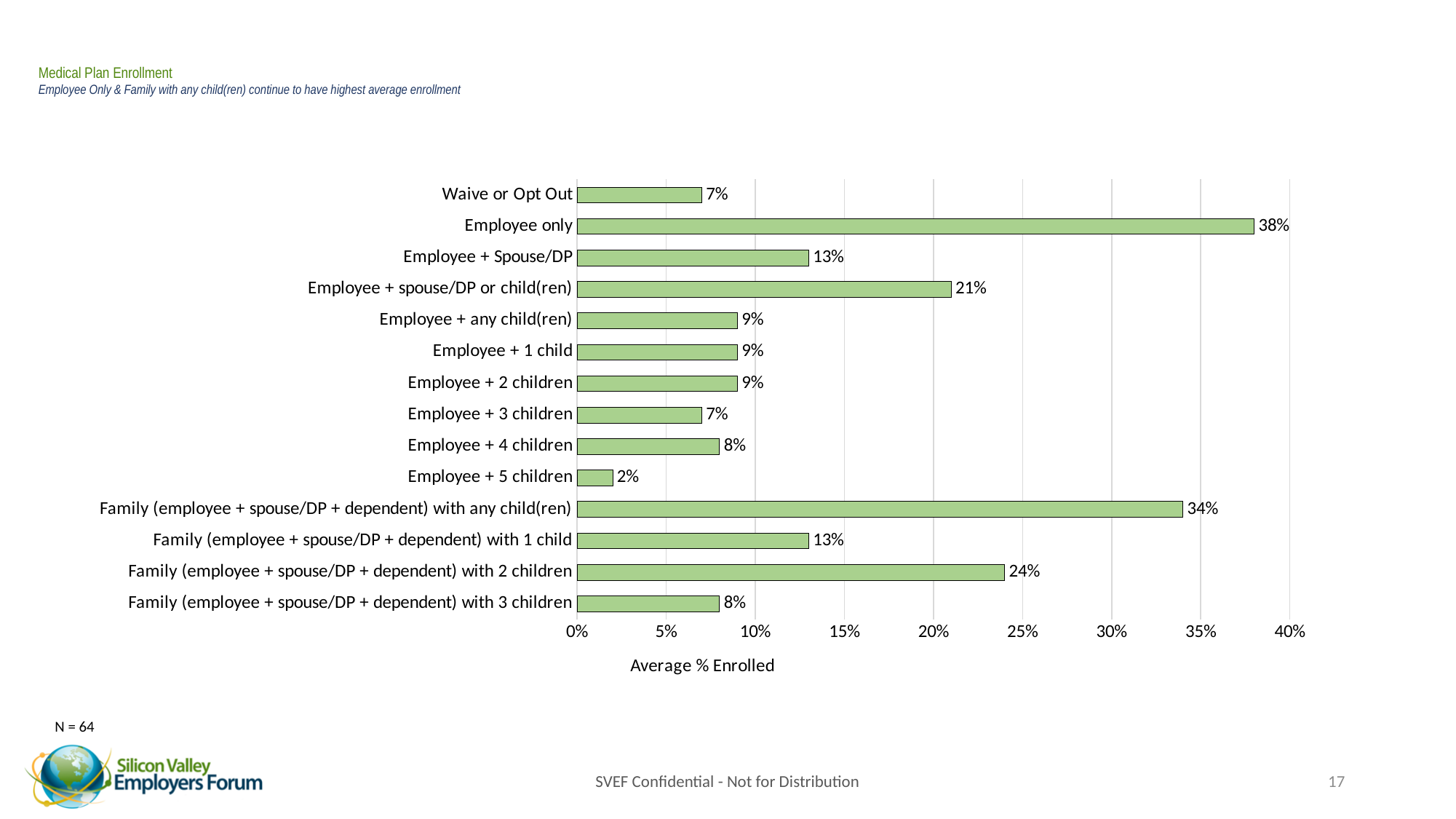
What is the average % enrolled for Employee + 5 children? 2% What kind of chart is shown on the slide? Bar chart Is the value for Family (employee + spouse/DP + dependent) with any child(ren) greater or less than 30%? greater What is the x-axis title of the chart? Average % Enrolled What is the average % enrolled for Family (employee + spouse/DP + dependent) with 2 children? 24% What is the difference in average % enrolled between Employee only and Family (employee + spouse/DP + dependent) with any child(ren)? 4% How many categories are shown in the chart? 14 Which category has the lowest average % enrolled? Employee + 5 children Which category has the highest average % enrolled? Employee only What is the average % enrolled for Employee + spouse/DP or child(ren)? 21% Which has a higher average % enrolled: Employee + Spouse/DP or Employee + spouse/DP or child(ren)? Employee + spouse/DP or child(ren) What is the average % enrolled for Employee only? 38%